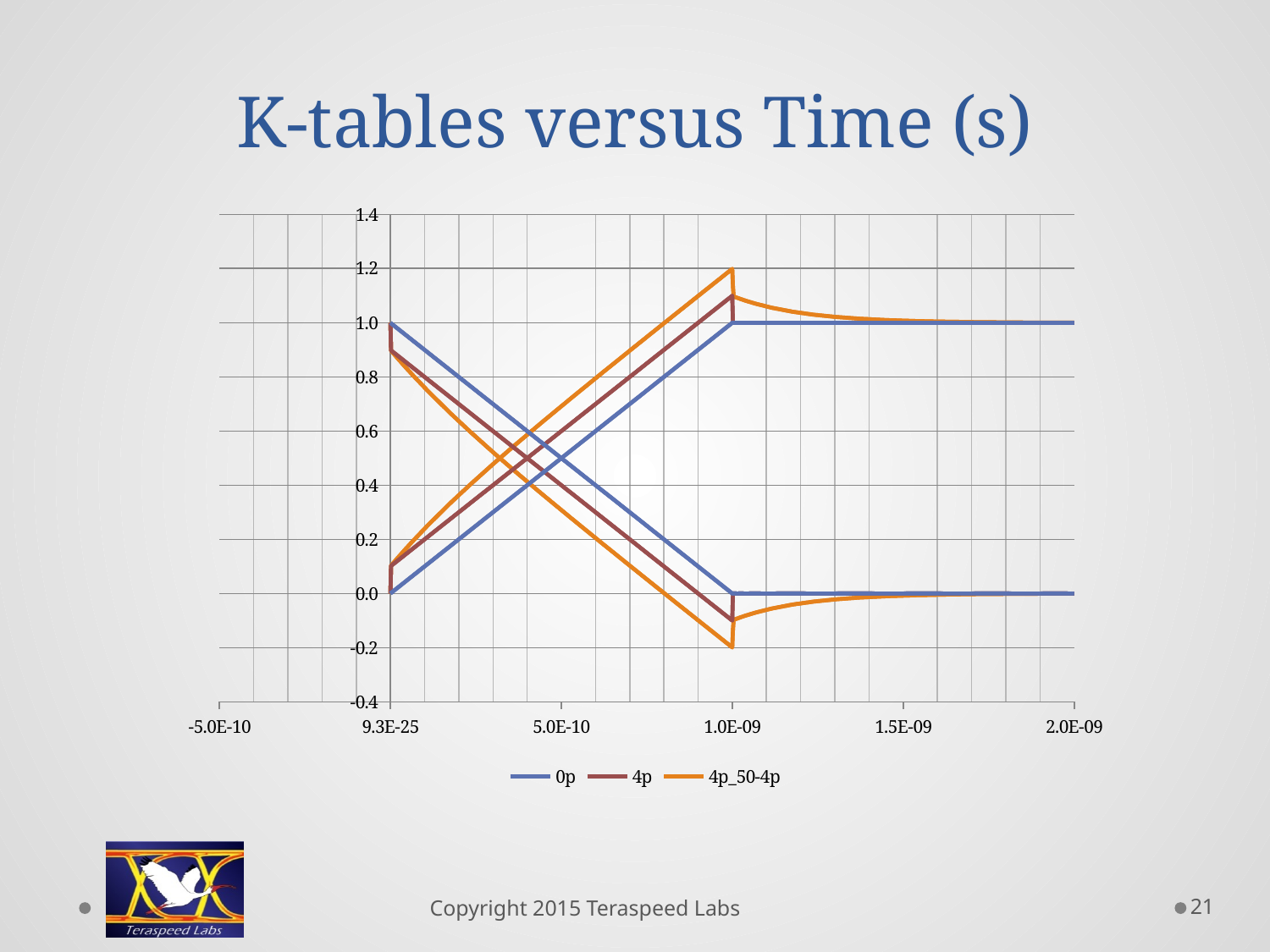
What is the title of the chart? K-tables versus Time (s) What are the series names listed in the legend? 0p, 4p, 4p_50-4p Which series reaches the lowest value on the chart? 4p_50-4p Which series reaches the highest peak value on the chart? 4p_50-4p Is the highest value reached by the 0p series greater or less than 1.2? less What kind of chart is shown on the slide? line chart Is the lowest value reached by the 4p series greater or less than 0.2? less Does the 0p line that starts at 0.0 rise or fall between 9.3E-25 and 1.0E-09? rise How many series does the legend list? 3 Is the peak value of the 4p_50-4p series near 1.0E-09 greater or less than 1.0? greater